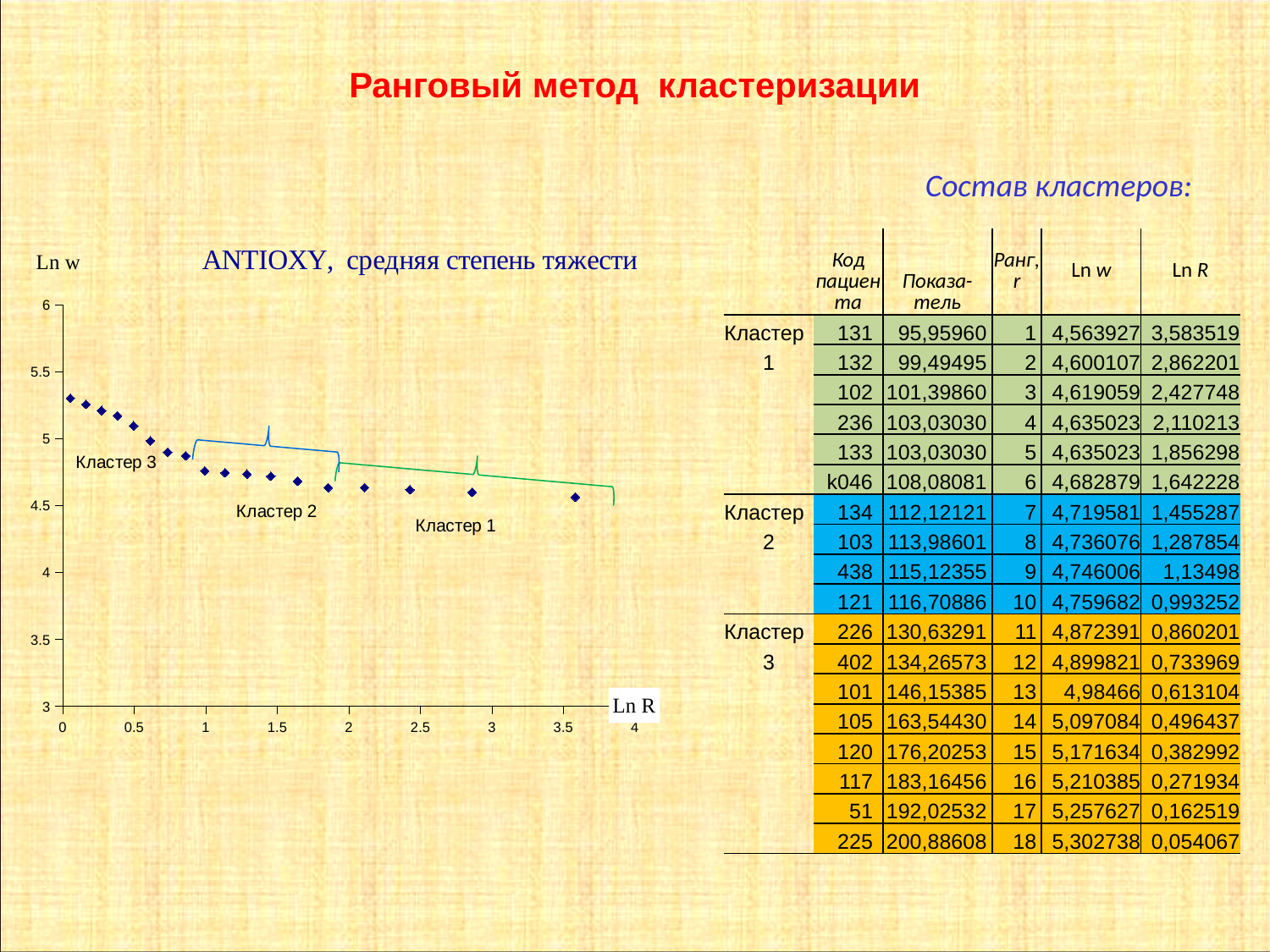
Which cluster label is placed nearest the left end of the chart, where Ln w is highest? Кластер 3 What label is on the vertical axis of the chart? Ln w Which point has the higher Ln w value: the leftmost point or the rightmost point? the leftmost point Is the Ln w value of the leftmost point (near Ln R = 0) greater or less than 5? greater Is the Ln w value of the rightmost point (near Ln R = 3.5) greater or less than 5? less What kind of chart is shown on the left of the slide? scatter chart Which cluster contains the point with the lowest Ln w value? Кластер 1 How many clusters are marked on the chart? 3 How many data points are plotted on the chart? 18 What is the title of the chart on the left? ANTIOXY, средняя степень тяжести What is the highest tick value shown on the vertical axis of the chart? 6 Do the Ln w values rise or fall as Ln R increases along the x axis? fall